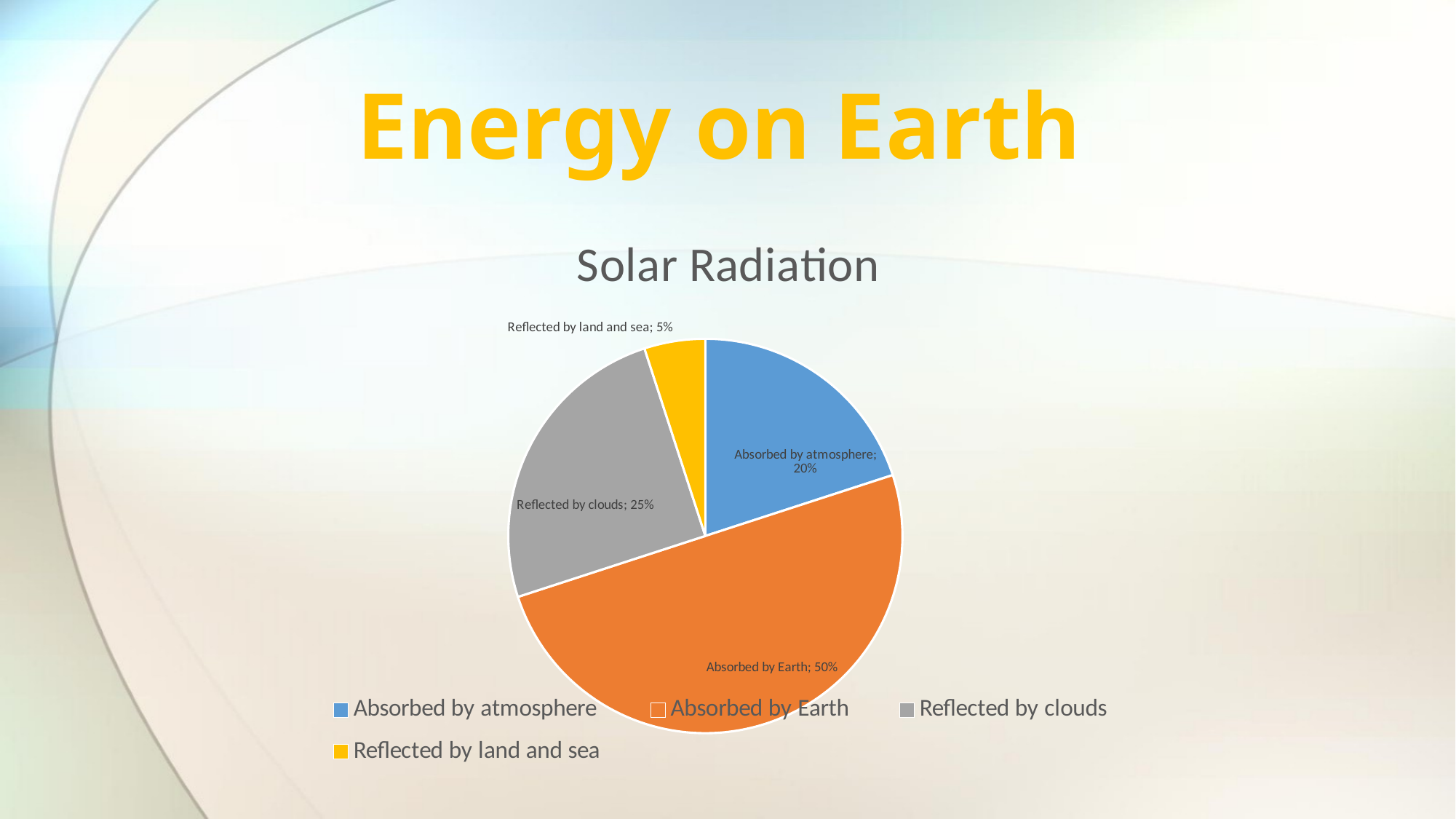
What percentage of solar radiation is reflected by land and sea? 5% Which is larger: the share reflected by clouds or the share absorbed by the atmosphere? Reflected by clouds What percentage of solar radiation is reflected by clouds? 25% What is the difference between the share absorbed by Earth and the share reflected by clouds? 25% What percentage of solar radiation is absorbed by Earth? 50% What colour is the slice for Reflected by land and sea? yellow What is the title of the chart? Solar Radiation Which category has the smallest share of the pie? Reflected by land and sea Which category has the largest share of the pie? Absorbed by Earth What percentage of solar radiation is absorbed by the atmosphere? 20% How many slices does the pie chart have? 4 What type of chart is shown on the slide? pie chart